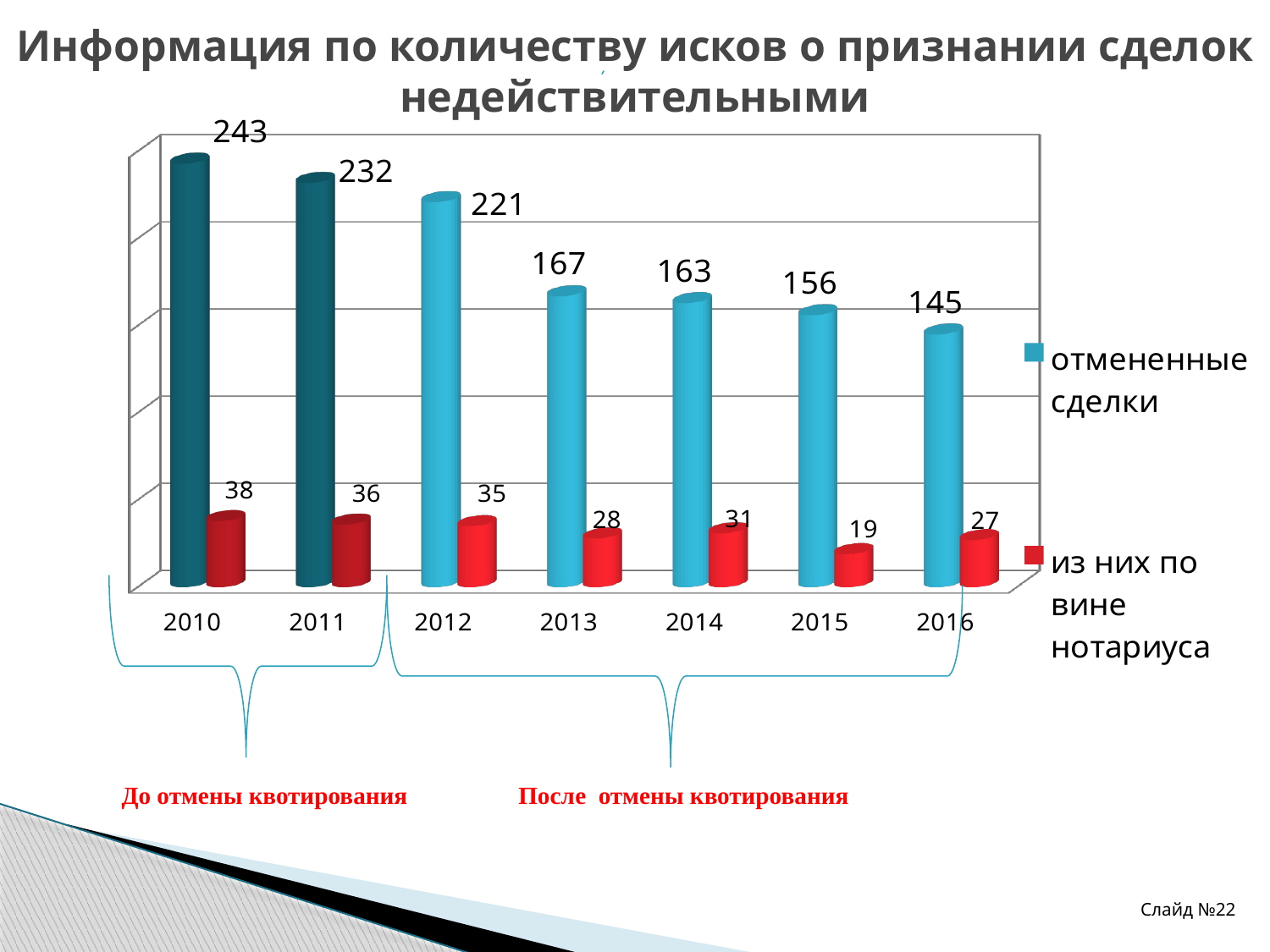
Do the values for 'отмененные сделки' rise or fall from 2010 to 2016? fall What is the value for 'из них по вине нотариуса' in 2015? 19 What is the value for 'отмененные сделки' in 2010? 243 Which year has the highest value for 'отмененные сделки'? 2010 What kind of chart is shown on the slide? bar chart How many series does the legend list? 2 What is the difference between the 'отмененные сделки' values for 2012 and 2013? 54 What colour are the bars for 'из них по вине нотариуса'? red What is the value for 'отмененные сделки' in 2016? 145 Which is larger: 'из них по вине нотариуса' in 2013 or in 2014? 2014 Which year has the lowest value for 'из них по вине нотариуса'? 2015 How many years are shown on the x axis? 7